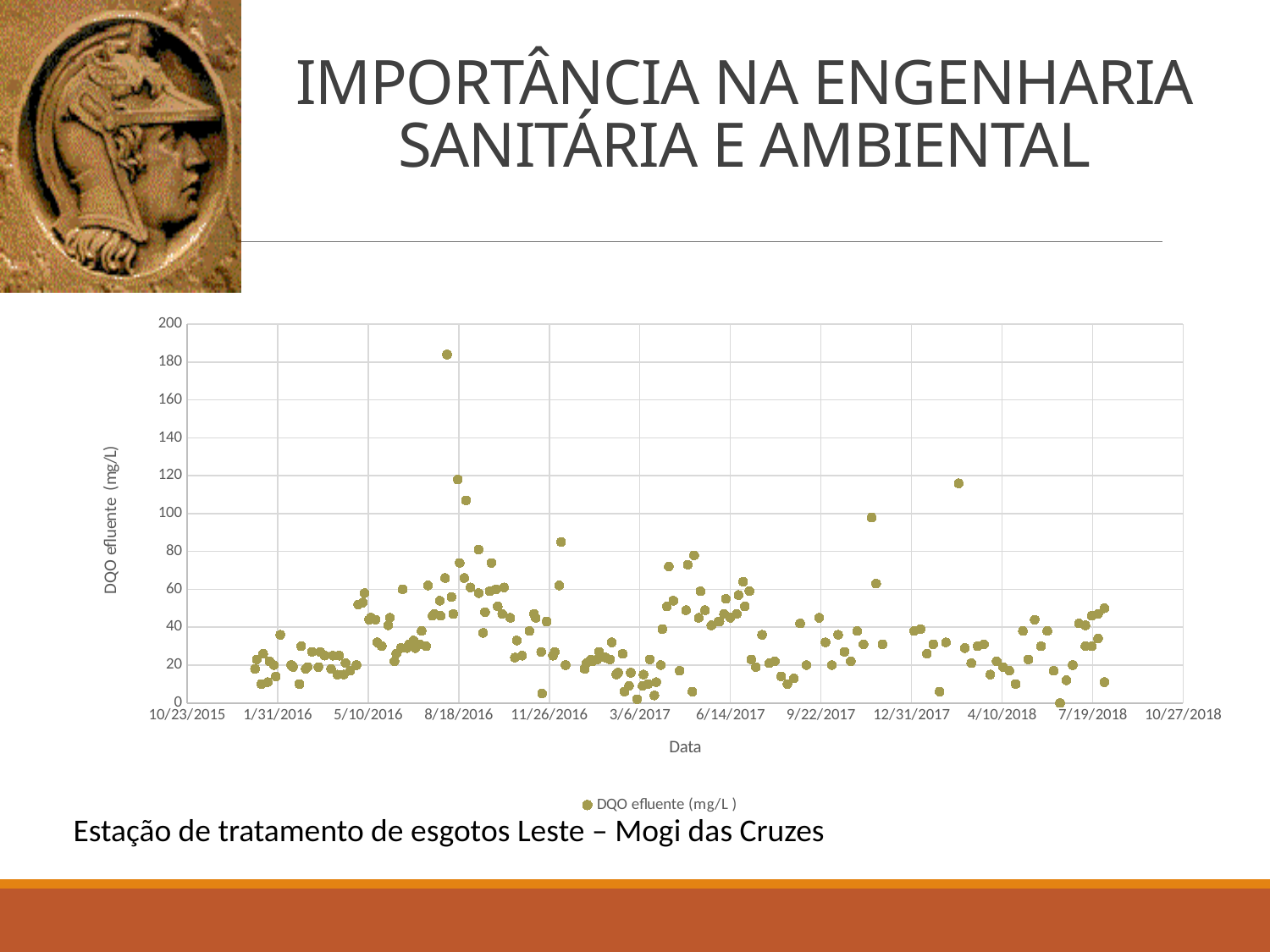
Is the lowest plotted value in the chart greater or less than 20? less Is the highest plotted value in the chart greater or less than 160? greater How many series does the chart legend list? 1 What is the maximum value shown on the vertical axis of the chart? 200 Is the highest plotted value in the chart greater or less than 200? less What kind of chart is shown on the slide? Scatter chart What is the interval between consecutive tick marks on the vertical axis of the chart? 20 What is the last date tick shown on the horizontal axis of the chart? 10/27/2018 What is the first date tick shown on the horizontal axis of the chart? 10/23/2015 What is the name of the series shown in the chart legend? DQO efluente (mg/L ) What is the title of the vertical axis of the chart? DQO efluente (mg/L)